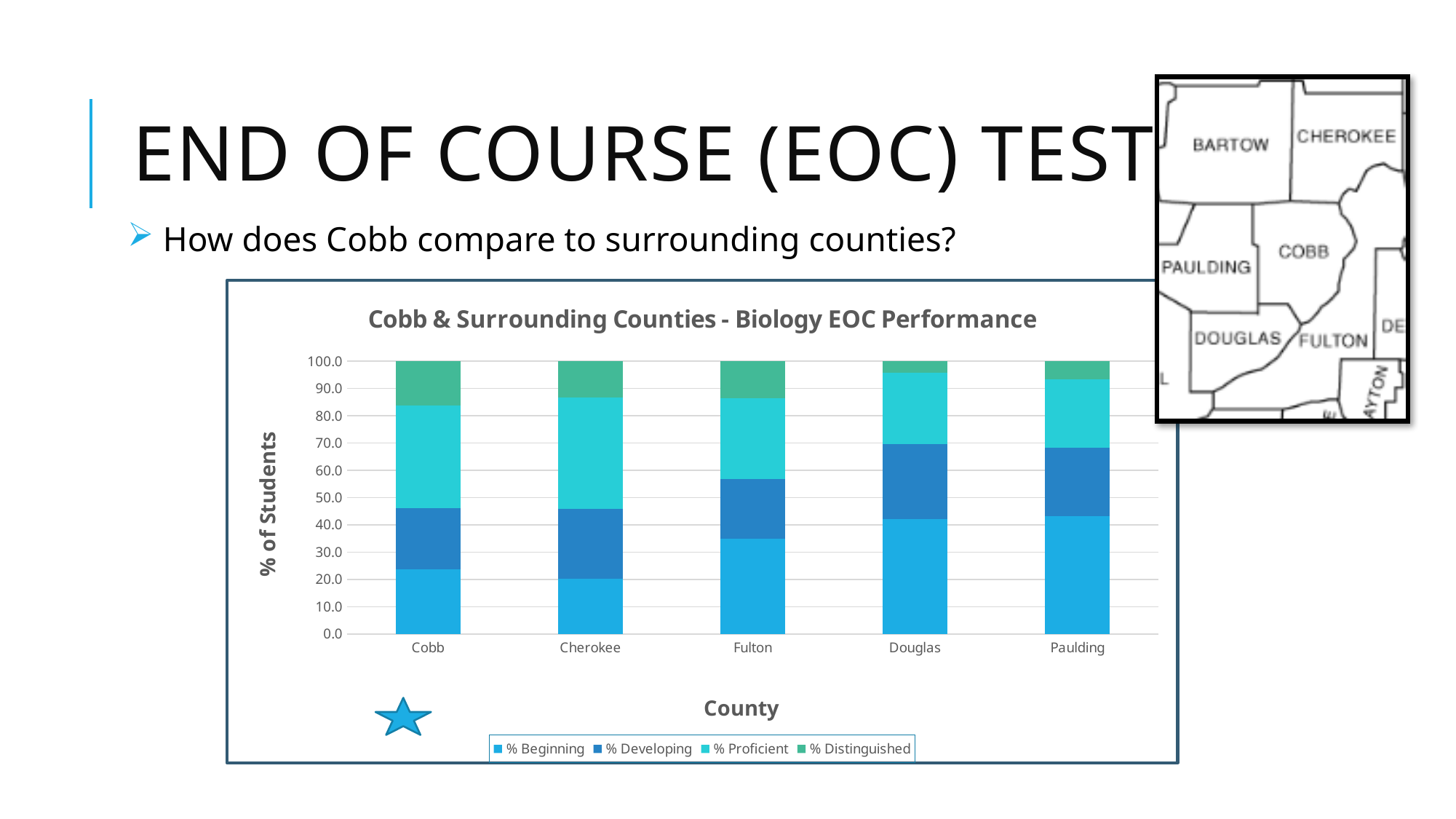
What is the total height of the stacked bar for Cobb? 100.0 What is the label on the vertical axis of the chart? % of Students What kind of chart is shown on the slide? Stacked bar chart Is the % Beginning value for Fulton greater or less than 30.0? greater Is the % Beginning value for Cherokee greater or less than 30.0? less Which county has a larger % Beginning segment, Fulton or Cobb? Fulton How many series does the chart's legend list? 4 Which county has a larger % Proficient segment, Cobb or Douglas? Cobb How many counties are shown on the x axis of the chart? 5 Is the % Beginning value for Cobb greater or less than 30.0? less Which county has the smallest % Distinguished segment? Douglas What is the title of the chart? Cobb & Surrounding Counties - Biology EOC Performance